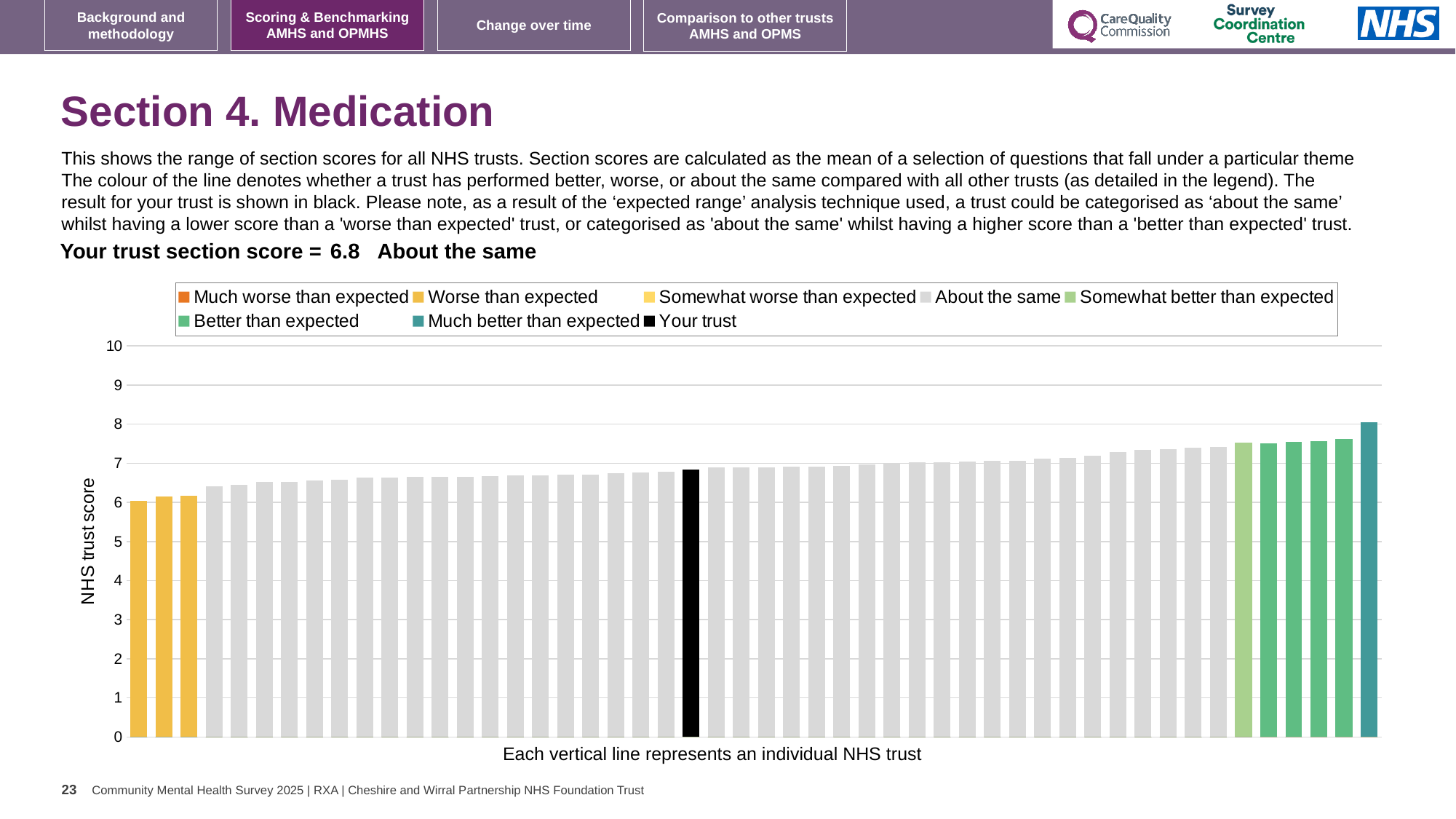
Which performance category is your trust placed in for Section 4. Medication? About the same How many entries does the chart legend list? 8 What is the section score for your trust shown on the slide? 6.8 Is the value of the lowest bar in the chart greater or less than 7? less Is the value of the tallest bar in the chart greater or less than 7? greater Which is taller, the leftmost bar or the rightmost bar? The rightmost bar What kind of chart is shown on the slide? Bar chart How many bars are coloured as 'Worse than expected'? 3 Is the value of the black 'Your trust' bar greater or less than 5? greater Which legend category does the tallest bar in the chart belong to? Much better than expected Do the bar values rise or fall from left to right along the x axis? Rise What is the title of the vertical axis? NHS trust score